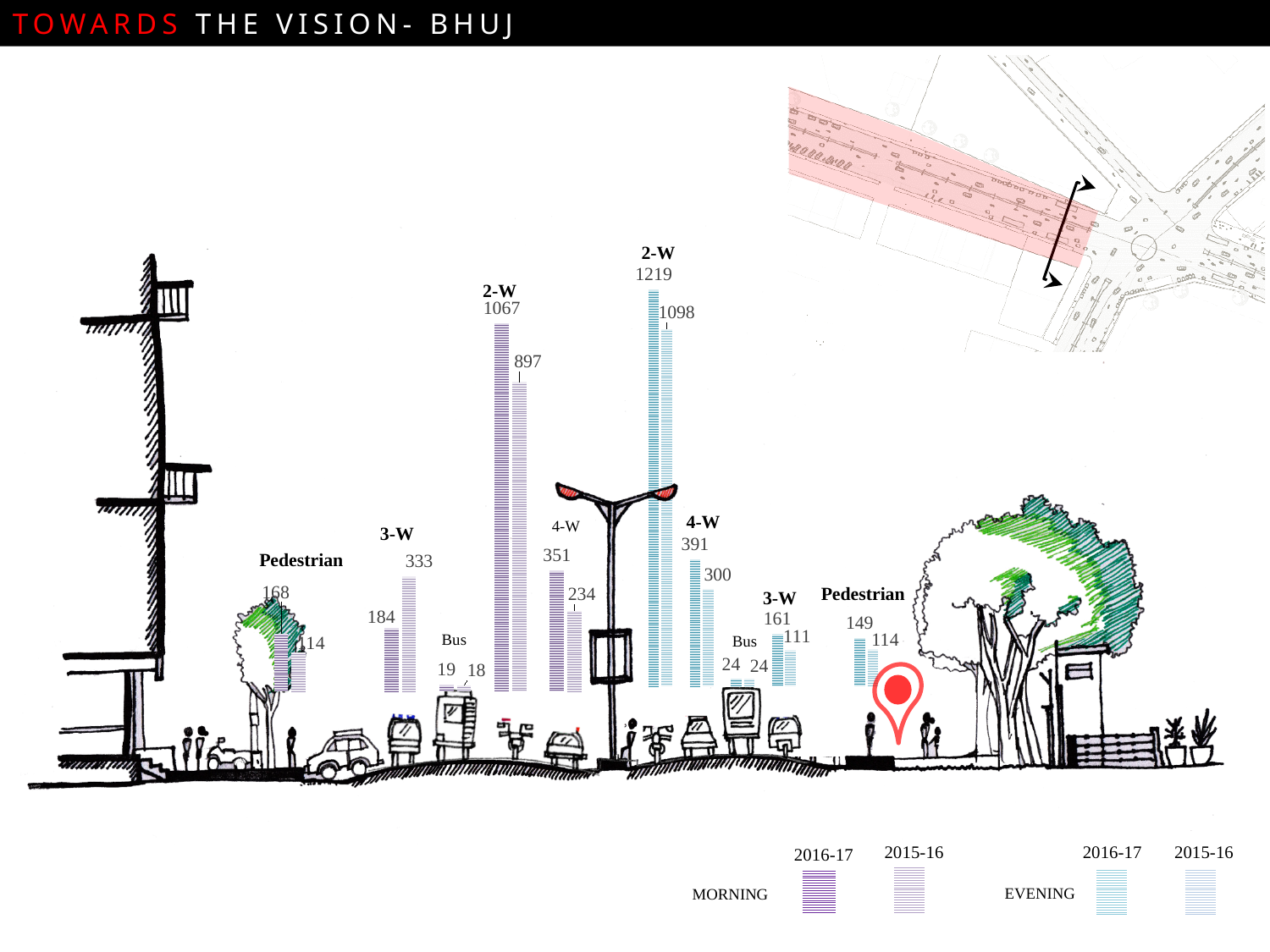
In the evening chart, what is the 2-W count for 2015-16? 1098 In the morning chart, what is the difference between the 2-W counts for 2016-17 and 2015-16? 170 In the morning chart, which is larger for 3-W: the 2016-17 count or the 2015-16 count? 2015-16 In the morning chart, which category has the lowest count in 2016-17? Bus In the evening chart, which category has the highest count in 2016-17? 2-W In the morning chart, what is the 2-W count for 2016-17? 1067 In the morning chart, what is the 3-W count for 2015-16? 333 How many categories are shown in the evening chart? 5 In the evening chart, what is the difference between the 4-W counts for 2016-17 and 2015-16? 91 How many series does the legend list for the morning chart? 2 What colour are the bars of the evening chart? Blue In the evening chart, what is the Pedestrian count for 2016-17? 149